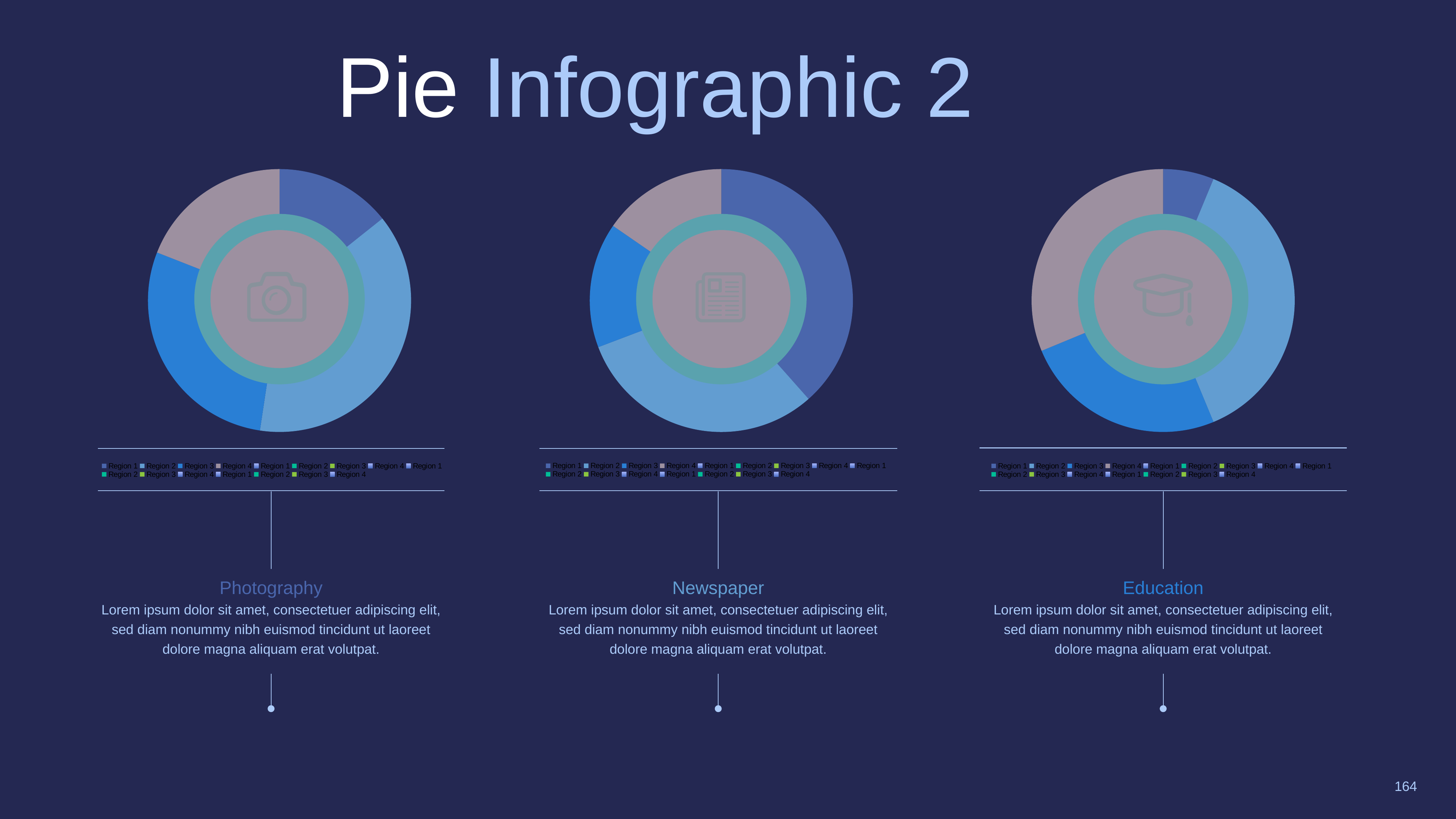
What category names appear in the legend of the Photography pie chart? Region 1, Region 2, Region 3, Region 4 In the Photography pie chart, which colour slice is the smallest? Dark blue In the Education pie chart, which colour slice is the smallest? Dark blue In the Education pie chart, is the light blue slice larger or smaller than the dark blue slice? Larger How many slices does the Education pie chart have? 4 What kind of chart is shown above the label "Photography"? Pie chart How many slices does the Newspaper pie chart have? 4 In the Newspaper pie chart, which colour slice is the largest? Dark blue How many slices does the Photography pie chart have? 4 In the Photography pie chart, which colour slice is the largest? Light blue What are the three labels under the pie charts, from left to right? Photography, Newspaper, Education